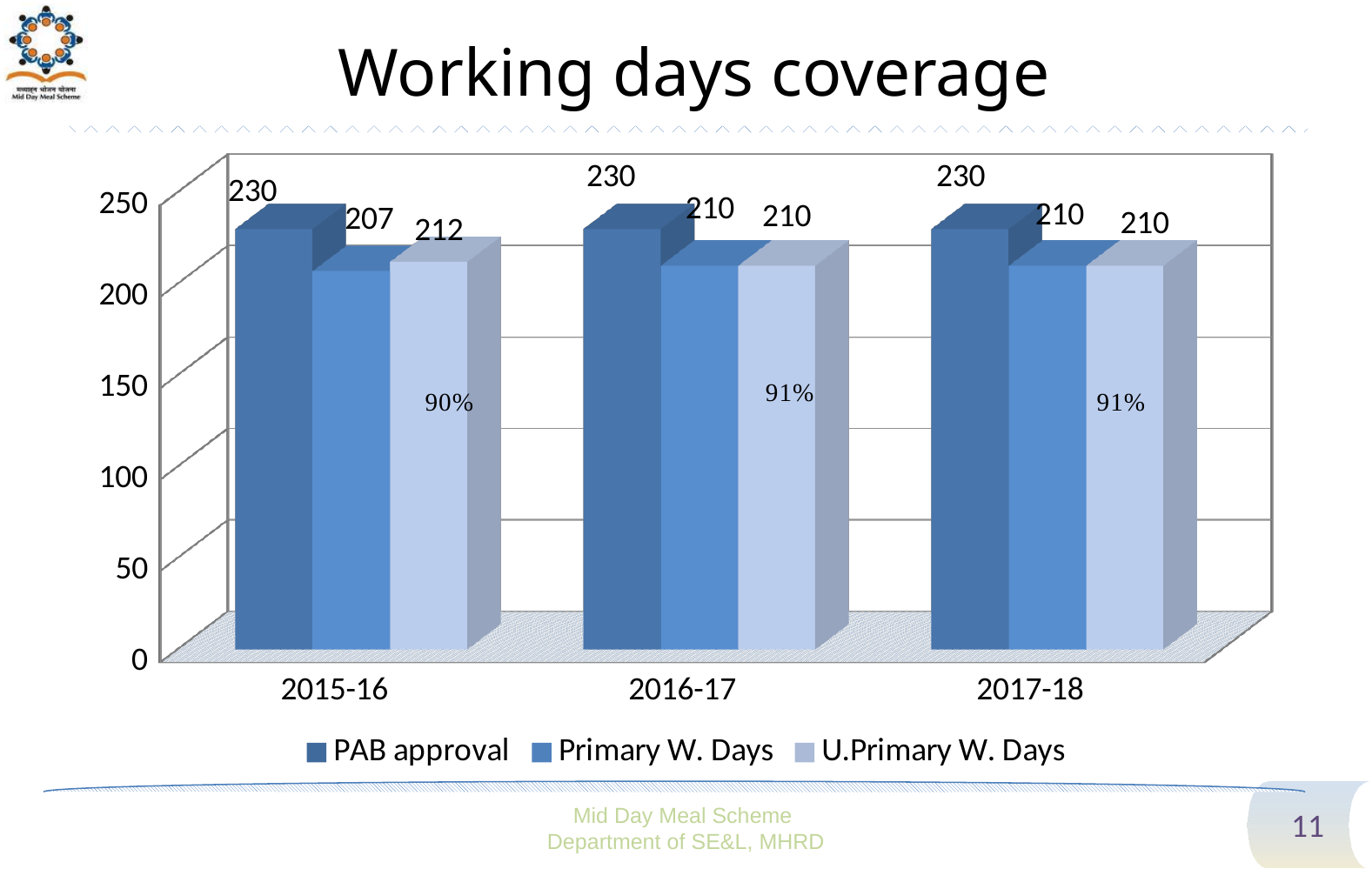
How many year categories are shown on the x axis? 3 How many series does the legend list? 3 What is the difference between PAB approval and U.Primary W. Days in 2017-18? 20 Which is larger in 2015-16, Primary W. Days or U.Primary W. Days? U.Primary W. Days What is the difference between PAB approval and Primary W. Days in 2015-16? 23 What is the PAB approval value for 2015-16? 230 What is the U.Primary W. Days value for 2015-16? 212 What kind of chart is shown on the slide? Bar chart What is the Primary W. Days value for 2015-16? 207 What percentage label is shown on the 2016-17 group of bars? 91% What is the title of the chart? Working days coverage What is the Primary W. Days value for 2017-18? 210